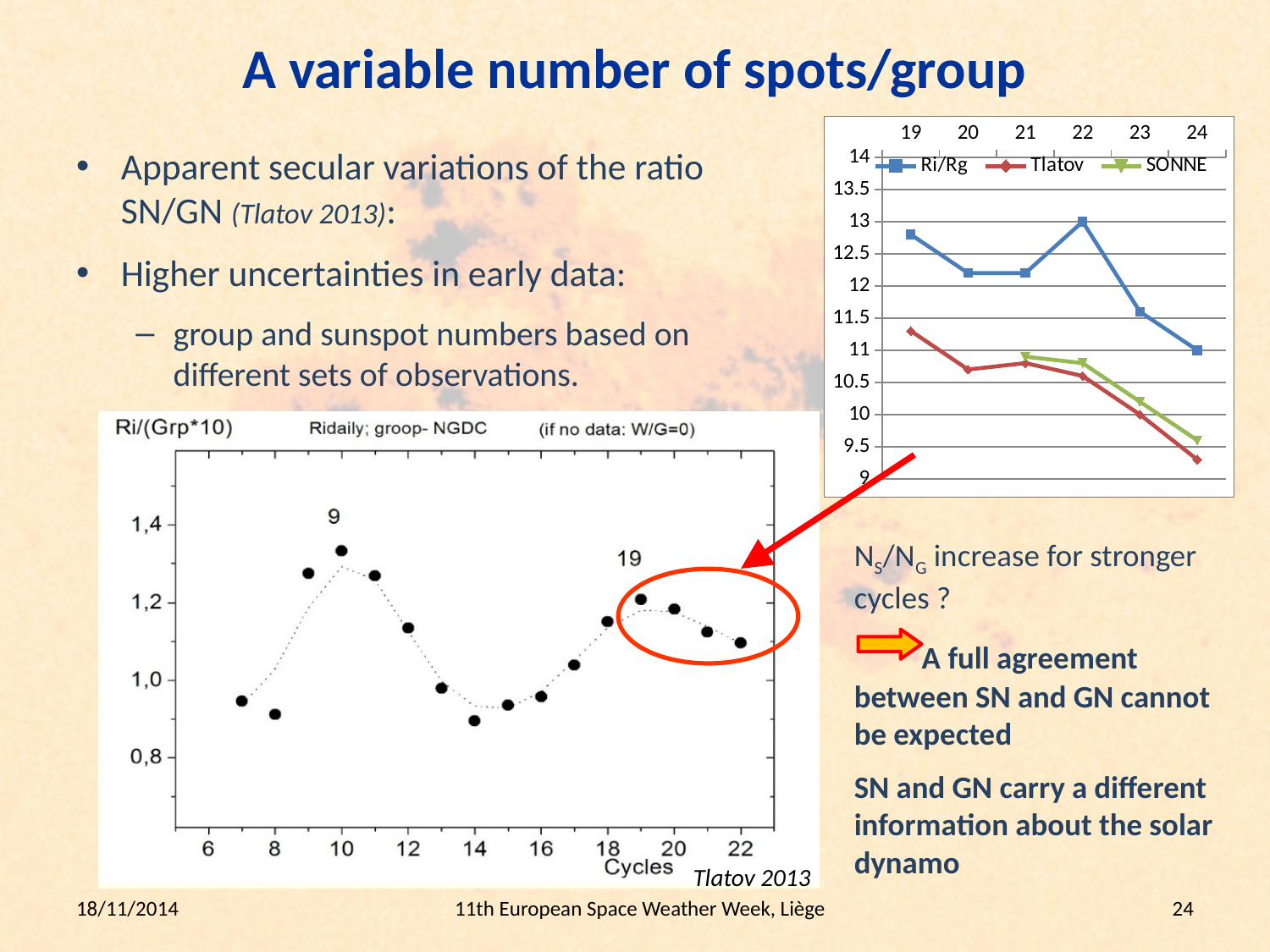
In the top-right chart, how many cycles are shown on the x axis? 6 In the top-right chart, at which cycle is the Ri/Rg series highest? 22 In the top-right chart, which series has the larger value at cycle 19, Ri/Rg or Tlatov? Ri/Rg In the top-right chart, how many series does the legend list? 3 What kind of chart is the top-right chart? line chart In the top-right chart, is the Ri/Rg value at cycle 19 greater or less than 12.5? greater In the bottom-left chart, is the value at cycle 10 greater or less than 1.2? greater In the top-right chart, is the Tlatov value at cycle 24 greater or less than 9.5? less In the top-right chart, does the Tlatov series generally rise or fall from cycle 19 to cycle 24? fall In the top-right chart, at which cycle is the Ri/Rg series lowest? 24 In the top-right chart, what are the names of the series in the legend? Ri/Rg, Tlatov, SONNE